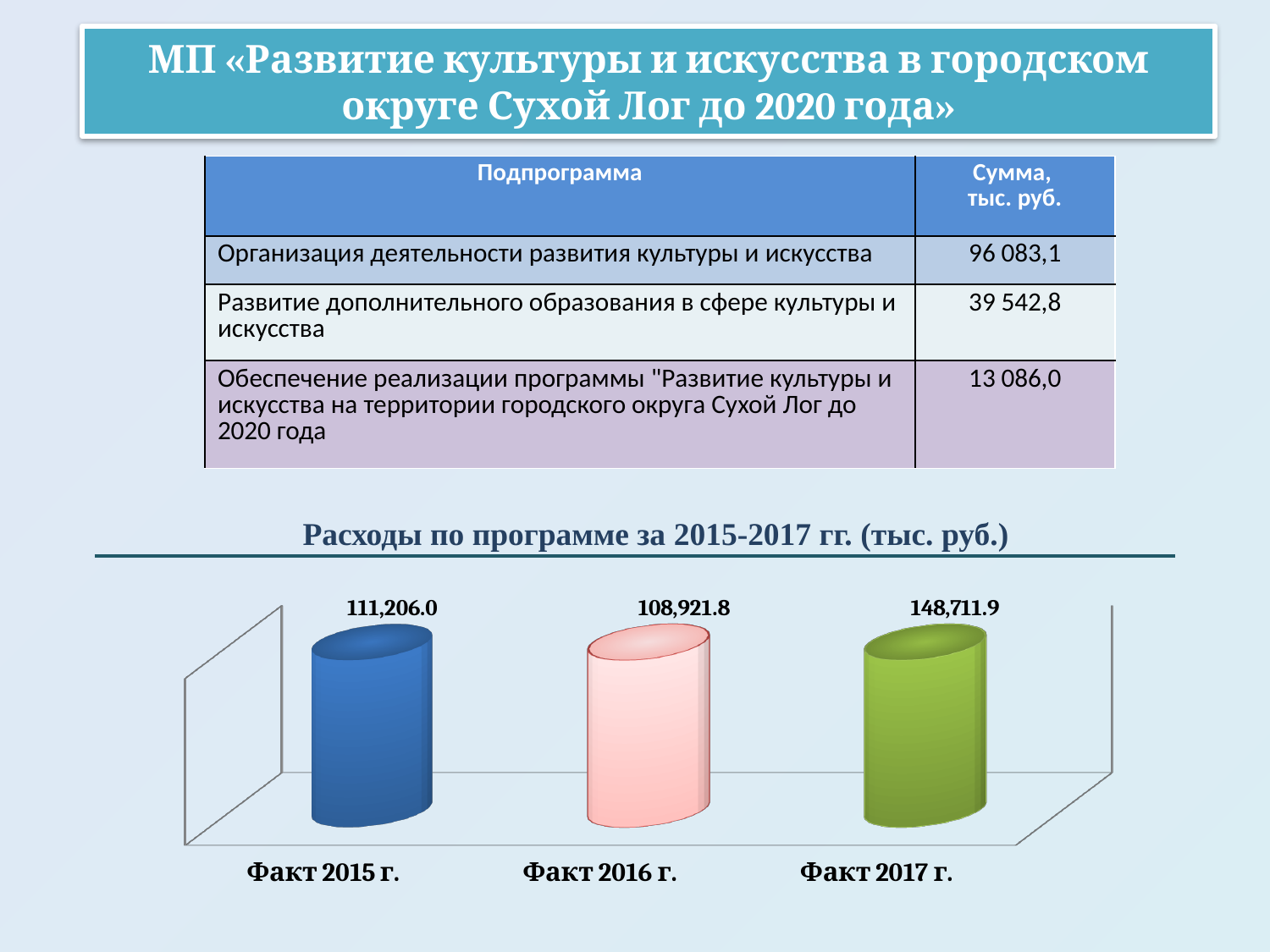
What is the value for Факт 2017 г. in the chart? 148,711.9 What is the value for Факт 2015 г. in the chart? 111,206.0 How many categories are shown in the chart? 3 What is the difference between the values for Факт 2017 г. and Факт 2015 г.? 37,505.9 What is the value for Факт 2016 г. in the chart? 108,921.8 What is the title of the chart? Расходы по программе за 2015-2017 гг. (тыс. руб.) Does the value rise or fall from Факт 2016 г. to Факт 2017 г.? Rise Which category has the highest value in the chart? Факт 2017 г. Which is larger, the value for Факт 2015 г. or the value for Факт 2016 г.? Факт 2015 г. Which category has the lowest value in the chart? Факт 2016 г. What is the difference between the values for Факт 2015 г. and Факт 2016 г.? 2,284.2 What kind of chart is shown on the slide? Bar chart